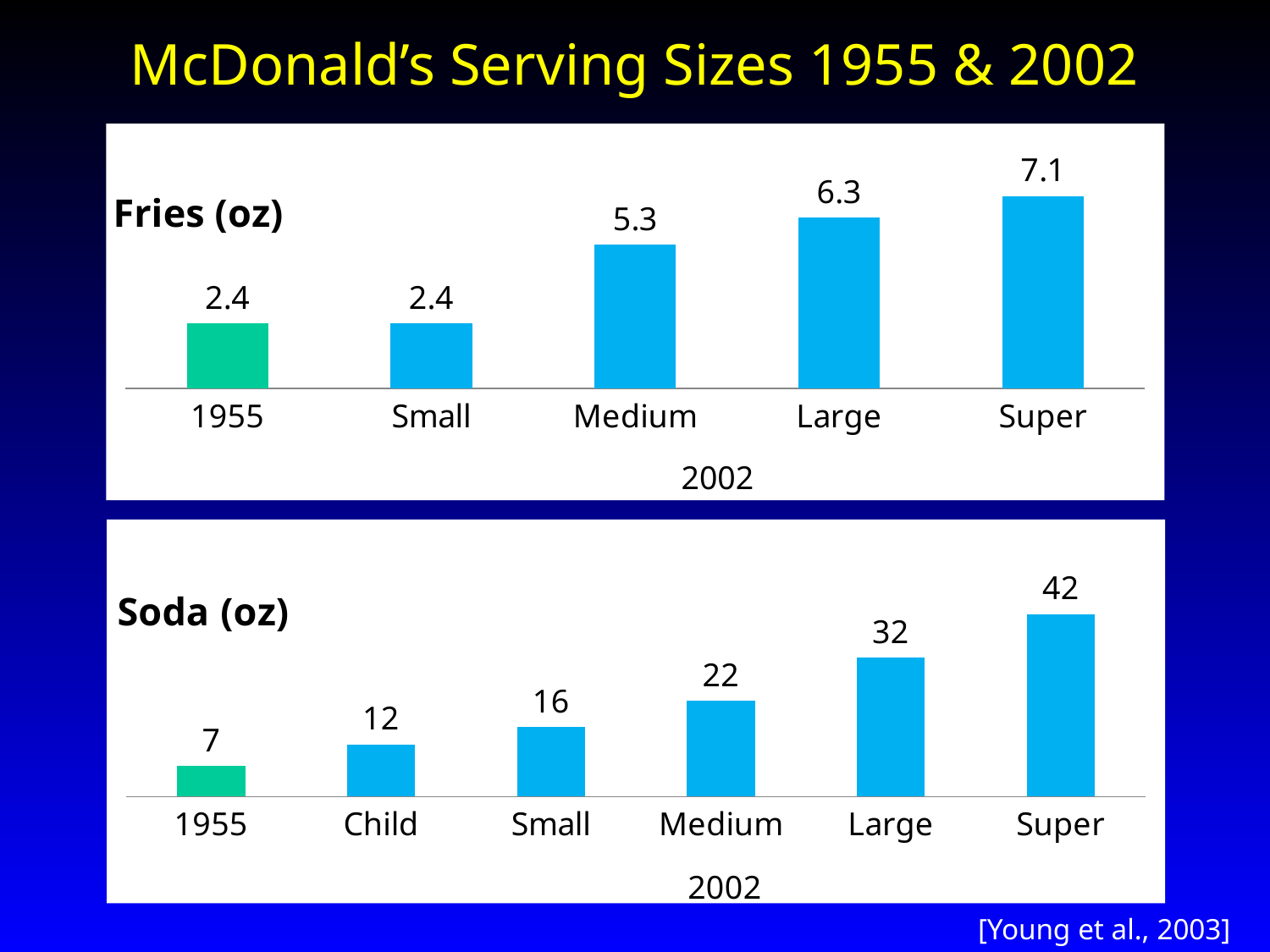
In the Fries (oz) chart, what is the difference between the 2002 Super size and the 1955 serving? 4.7 In the Soda (oz) chart, which is larger: the 2002 Small size or the 1955 serving? Small In the Fries (oz) chart, which 2002 size has the lowest value? Small In the Soda (oz) chart, what is the value for 1955? 7 In the Fries (oz) chart, what is the value for 1955? 2.4 In the Fries (oz) chart, what is the value for the 2002 Super size? 7.1 How many bars are in the Fries (oz) chart? 5 How many bars are in the Soda (oz) chart? 6 In the Soda (oz) chart, which category has the highest value? Super What type of chart is the Fries (oz) chart? Bar chart In the Soda (oz) chart, what is the value for the 2002 Medium size? 22 In the Soda (oz) chart, what is the difference between the 2002 Large and Child sizes? 20